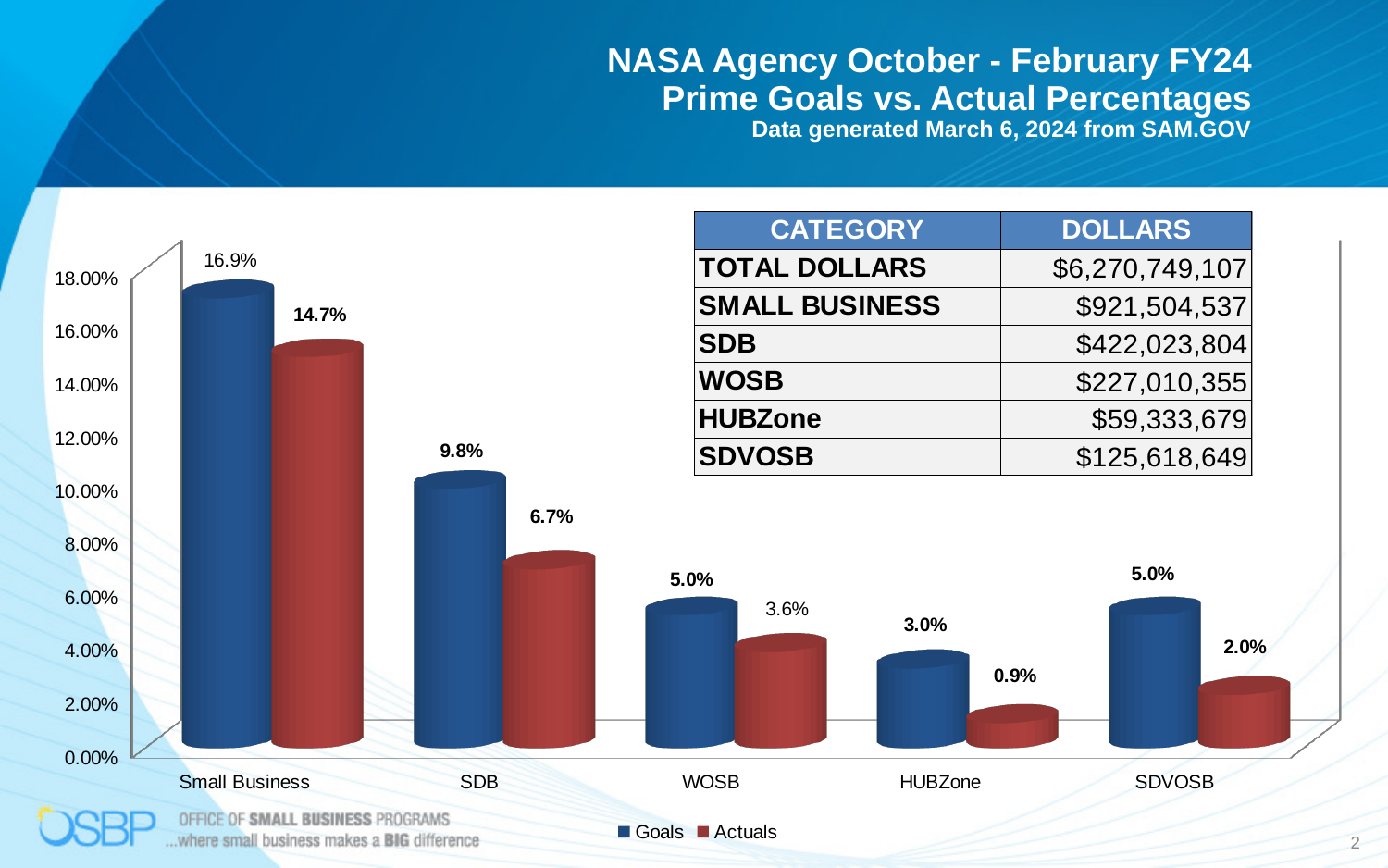
Which category has the lowest Goals value? HUBZone What is the Actuals value for SDB? 6.7% What kind of chart is shown on the slide? Bar chart What are the two series named in the chart legend? Goals and Actuals Which is larger, the Actuals value for WOSB or the Actuals value for SDVOSB? WOSB What is the difference between the Goals and Actuals values for Small Business? 2.2% What is the Goals value for Small Business? 16.9% How many categories are shown on the x axis of the chart? 5 Which category has the highest Actuals value? Small Business How many series does the chart legend list? 2 What is the Actuals value for HUBZone? 0.9% What is the Goals value for SDVOSB? 5.0%